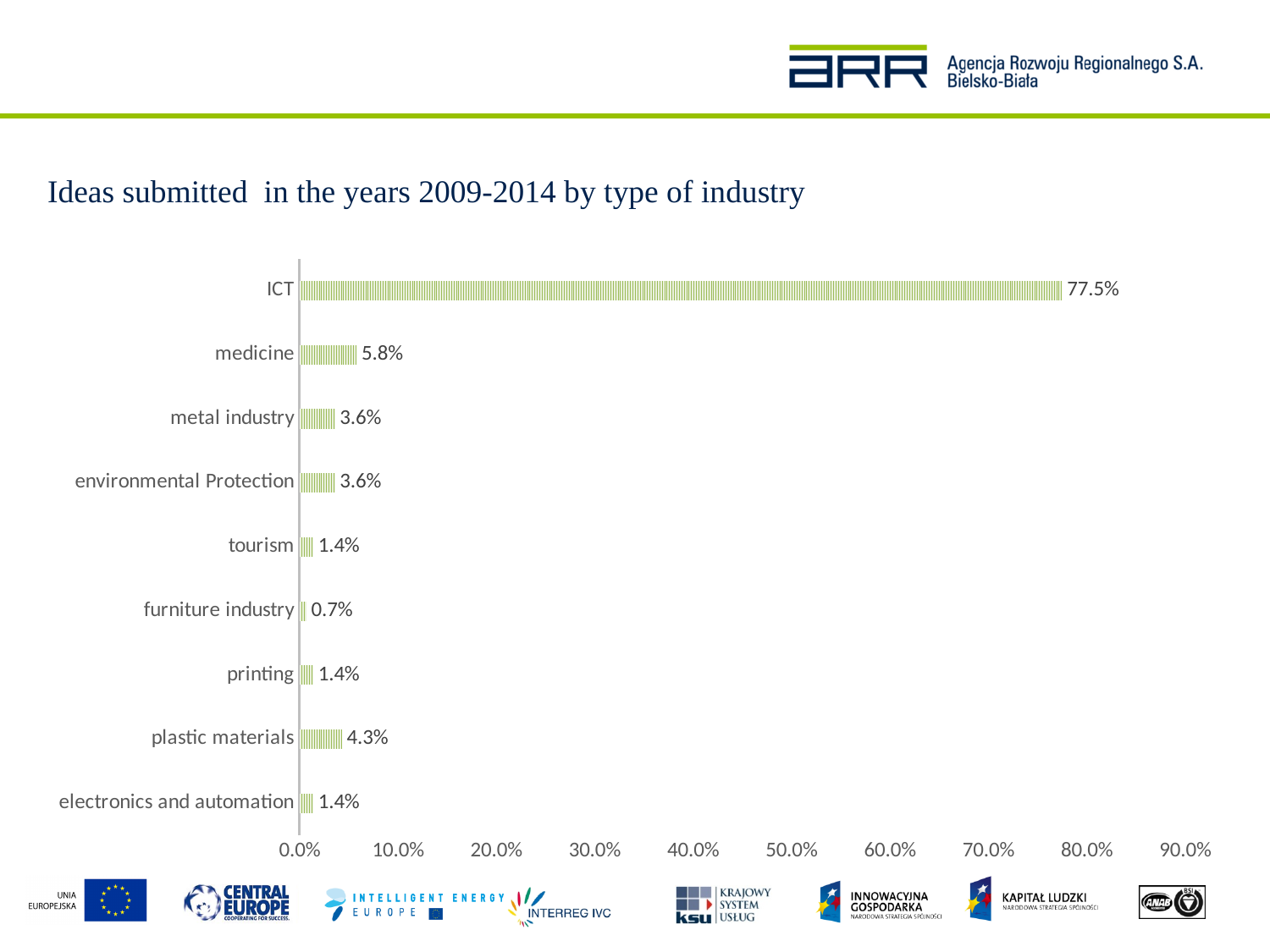
What is the difference between the values for ICT and medicine? 71.7% Which industry has the lowest share of ideas submitted? furniture industry Which is larger, the value for medicine or the value for plastic materials? medicine What kind of chart is shown on the slide? bar chart What is the value for plastic materials? 4.3% How many industry categories are shown in the chart? 9 What is the value for medicine? 5.8% What is the value for ICT? 77.5% What is the difference between the values for plastic materials and metal industry? 0.7% What is the value for furniture industry? 0.7% Which industry has the highest share of ideas submitted? ICT Is the value for ICT greater or less than 70.0%? greater